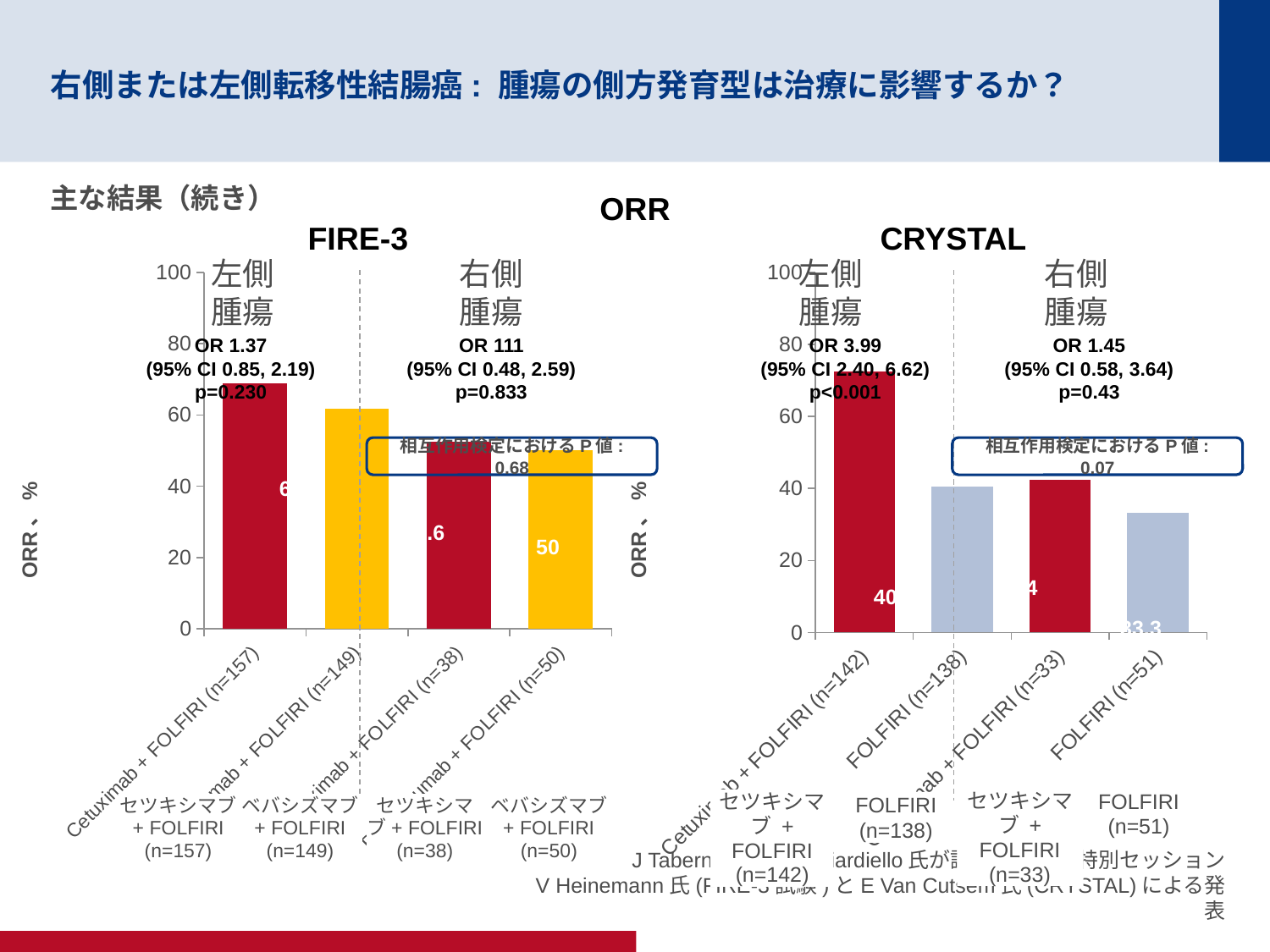
In the CRYSTAL chart, which treatment group has the lowest ORR? FOLFIRI (n=51) In the CRYSTAL chart, which is larger: the ORR for Cetuximab + FOLFIRI (n=142) or for FOLFIRI (n=138)? Cetuximab + FOLFIRI (n=142) In the FIRE-3 chart, which treatment group has the lowest ORR? Bevacizumab + FOLFIRI (n=50) What kind of chart is the FIRE-3 chart? bar chart In the FIRE-3 chart, what is the ORR value for Bevacizumab + FOLFIRI (n=50)? 50 What is the p-value for the interaction test shown in the CRYSTAL chart? 0.07 In the CRYSTAL chart, is the ORR for Cetuximab + FOLFIRI (n=142) greater or less than 60? greater In the FIRE-3 chart, which treatment group has the highest ORR? Cetuximab + FOLFIRI (n=157) How many bars are plotted in the CRYSTAL chart? 4 In the FIRE-3 chart, is the ORR for Cetuximab + FOLFIRI (n=157) greater or less than 60? greater In the CRYSTAL chart, is the ORR for FOLFIRI (n=138) greater or less than 60? less In the CRYSTAL chart, which treatment group has the highest ORR? Cetuximab + FOLFIRI (n=142)